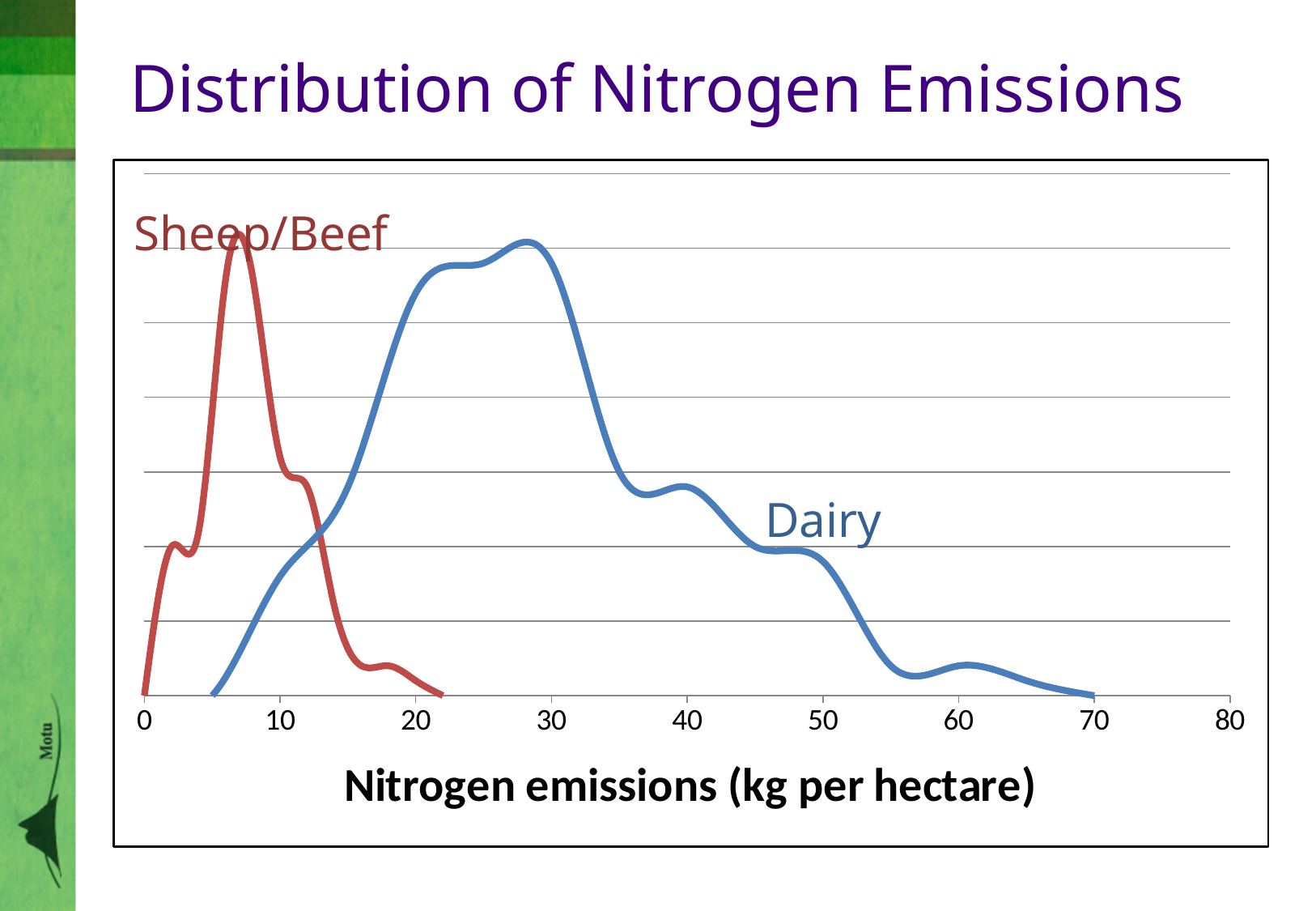
Is the peak of the Dairy curve located at a nitrogen emissions value greater or less than 20 kg per hectare? greater What kind of chart is shown on the slide? Line chart Does the Dairy curve extend to nitrogen emissions greater or less than 60 kg per hectare? greater Which series reaches its peak at a lower level of nitrogen emissions per hectare, Sheep/Beef or Dairy? Sheep/Beef Is the peak of the Sheep/Beef curve located at a nitrogen emissions value greater or less than 10 kg per hectare? less What is the highest value shown on the x axis of the chart? 80 Which series peaks at a higher level of nitrogen emissions per hectare, Sheep/Beef or Dairy? Dairy What is the title of the chart on the slide? Distribution of Nitrogen Emissions How many series are plotted on the chart? 2 What is the label on the x axis of the chart? Nitrogen emissions (kg per hectare)